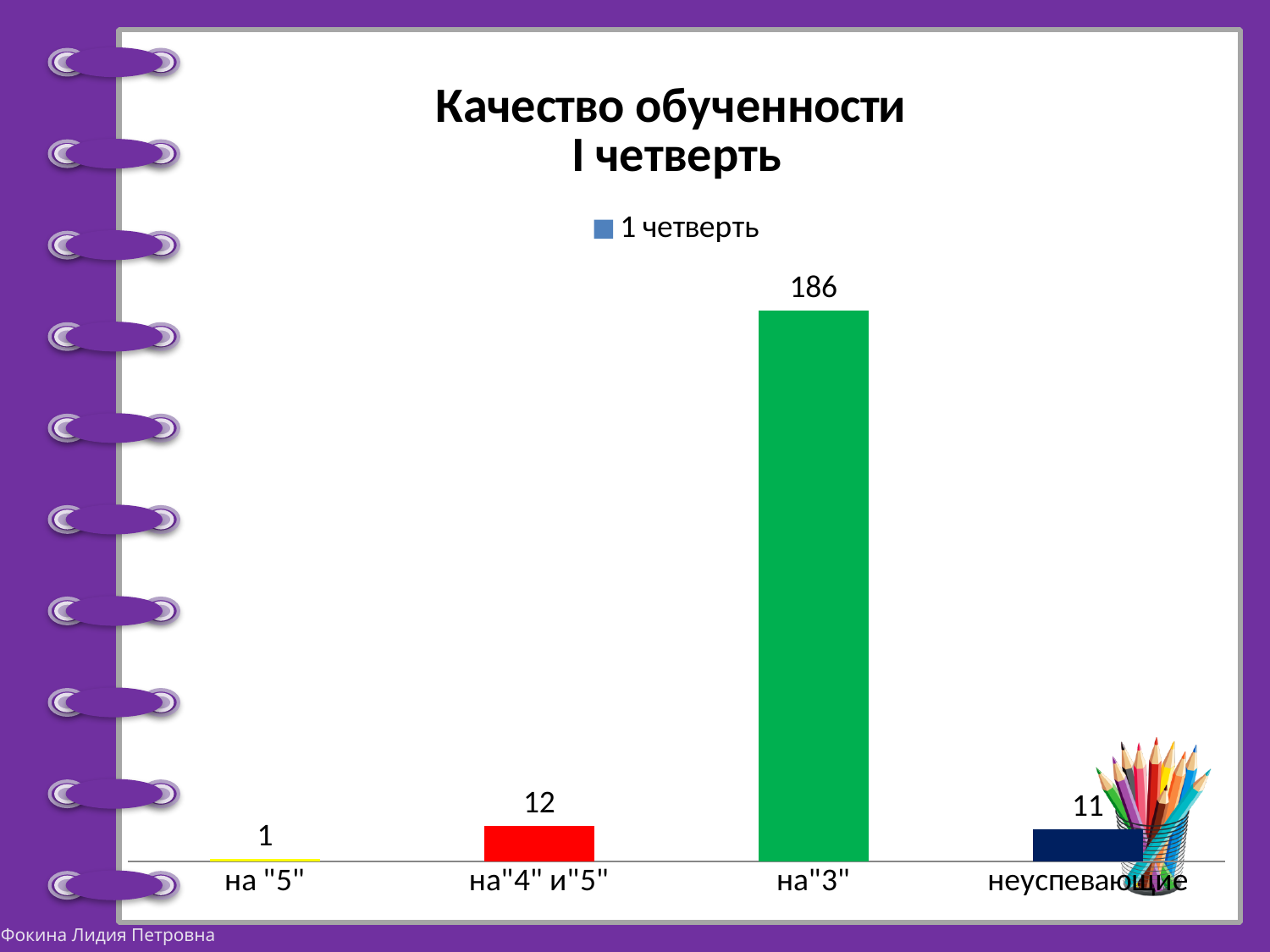
What is the value for на"4" и"5"? 12 What is the difference between the values for на"3" and на"4" и"5"? 174 Which is larger, the value for на"4" и"5" or the value for на "5"? на"4" и"5" Which category has the highest value? на"3" What series name does the legend show? 1 четверть How many categories are shown on the x axis? 4 What is the value for неуспевающие? 11 What is the value for на "5"? 1 Which category has the lowest value? на "5" What is the value for на"3"? 186 What kind of chart is shown on the slide? bar chart What is the difference between the values for на"4" и"5" and неуспевающие? 1